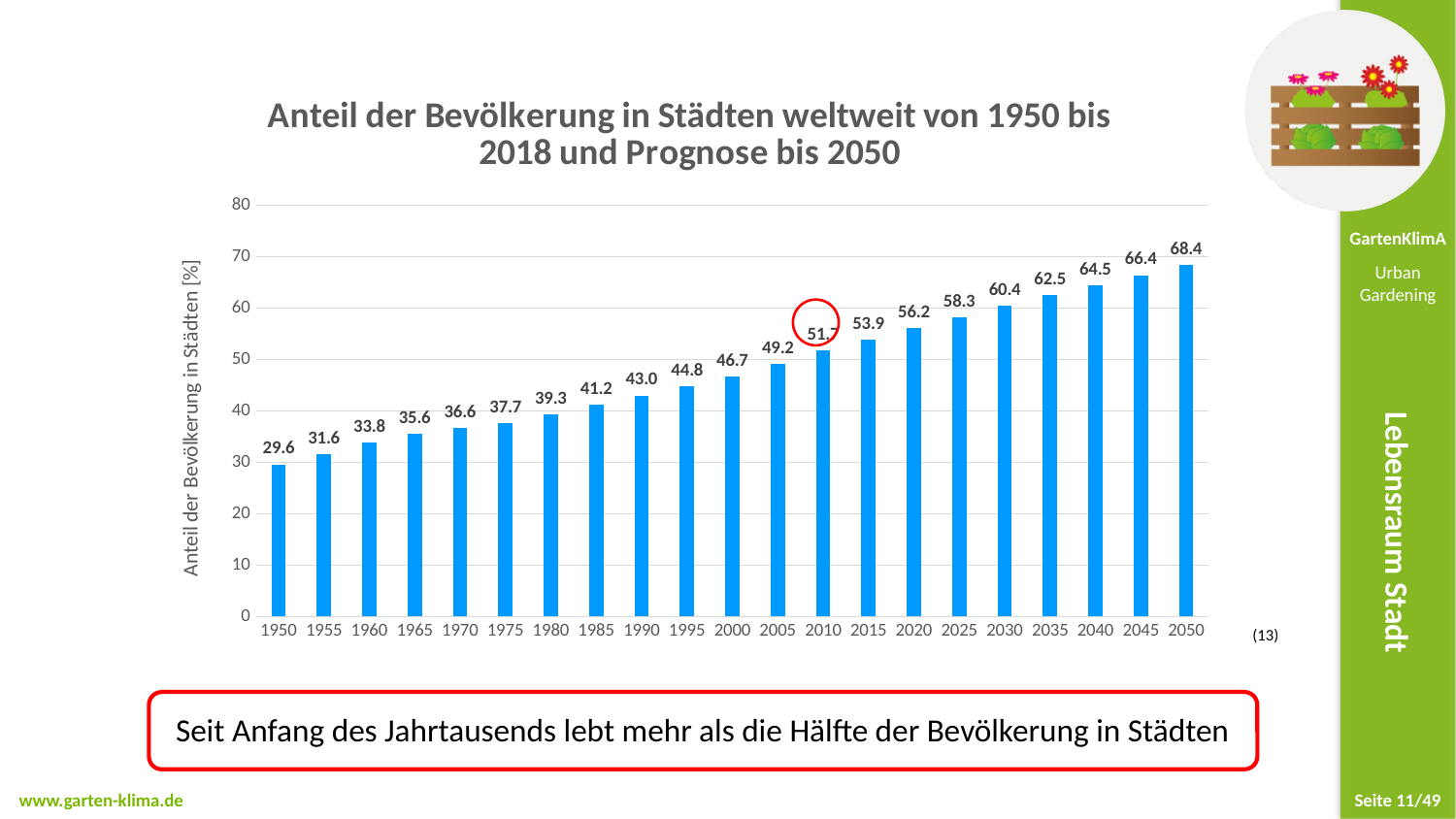
What is the value for 2030? 60.4 What kind of chart is shown? Bar chart What is the difference between the values for 2050 and 1950? 38.8 Do the values rise or fall from 1950 to 2050? Rise What is the value for 2050? 68.4 Which year has the lowest value? 1950 Which year has the highest value? 2050 Which is larger, the value for 1980 or the value for 1995? 1995 Is the value for 2020 greater or less than 50? greater What is the value for 2000? 46.7 How many years (bars) are shown on the x axis? 21 What is the value for 1950? 29.6